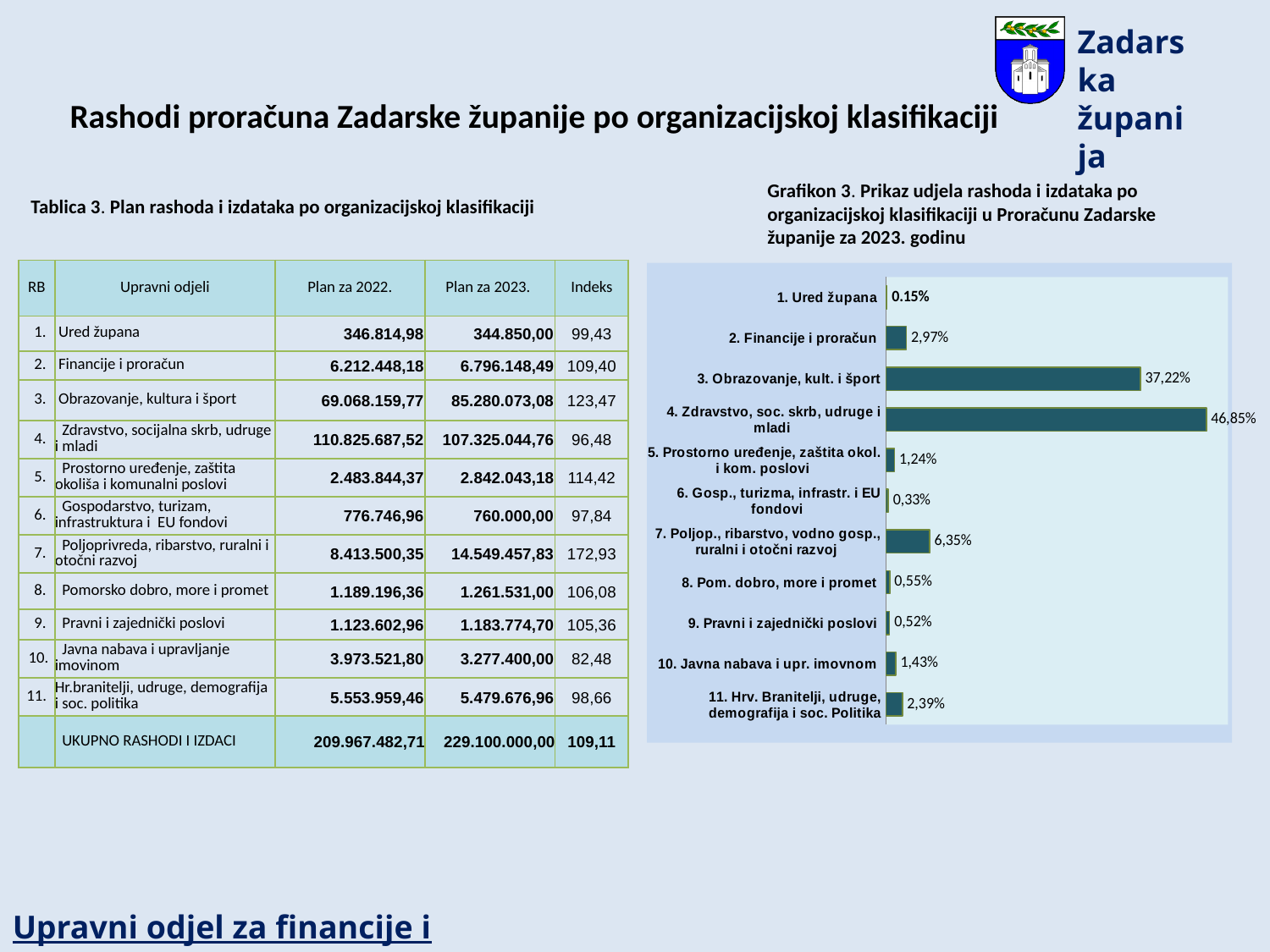
What is the title of the chart on the slide? Grafikon 3. Prikaz udjela rashoda i izdataka po organizacijskoj klasifikaciji u Proračunu Zadarske županije za 2023. godinu Which category has the lowest value in Grafikon 3? 1. Ured župana What kind of chart is Grafikon 3 on the slide? bar chart How many categories are shown in the bar chart Grafikon 3? 11 In Grafikon 3, what is the value for '3. Obrazovanje, kult. i šport'? 37,22% In Grafikon 3, what is the value for '10. Javna nabava i upr. imovnom'? 1,43% In Grafikon 3, what is the value for '7. Poljop., ribarstvo, vodno gosp., ruralni i otočni razvoj'? 6,35% In Grafikon 3, what is the value for '4. Zdravstvo, soc. skrb, udruge i mladi'? 46,85% Which category has the highest value in Grafikon 3? 4. Zdravstvo, soc. skrb, udruge i mladi In Grafikon 3, which is larger: the value for '2. Financije i proračun' or for '11. Hrv. Branitelji, udruge, demografija i soc. Politika'? 2. Financije i proračun In Grafikon 3, what is the difference between the values for '4. Zdravstvo, soc. skrb, udruge i mladi' and '3. Obrazovanje, kult. i šport'? 9,63% In Grafikon 3, what is the difference between the values for '7. Poljop., ribarstvo, vodno gosp., ruralni i otočni razvoj' and '2. Financije i proračun'? 3,38%